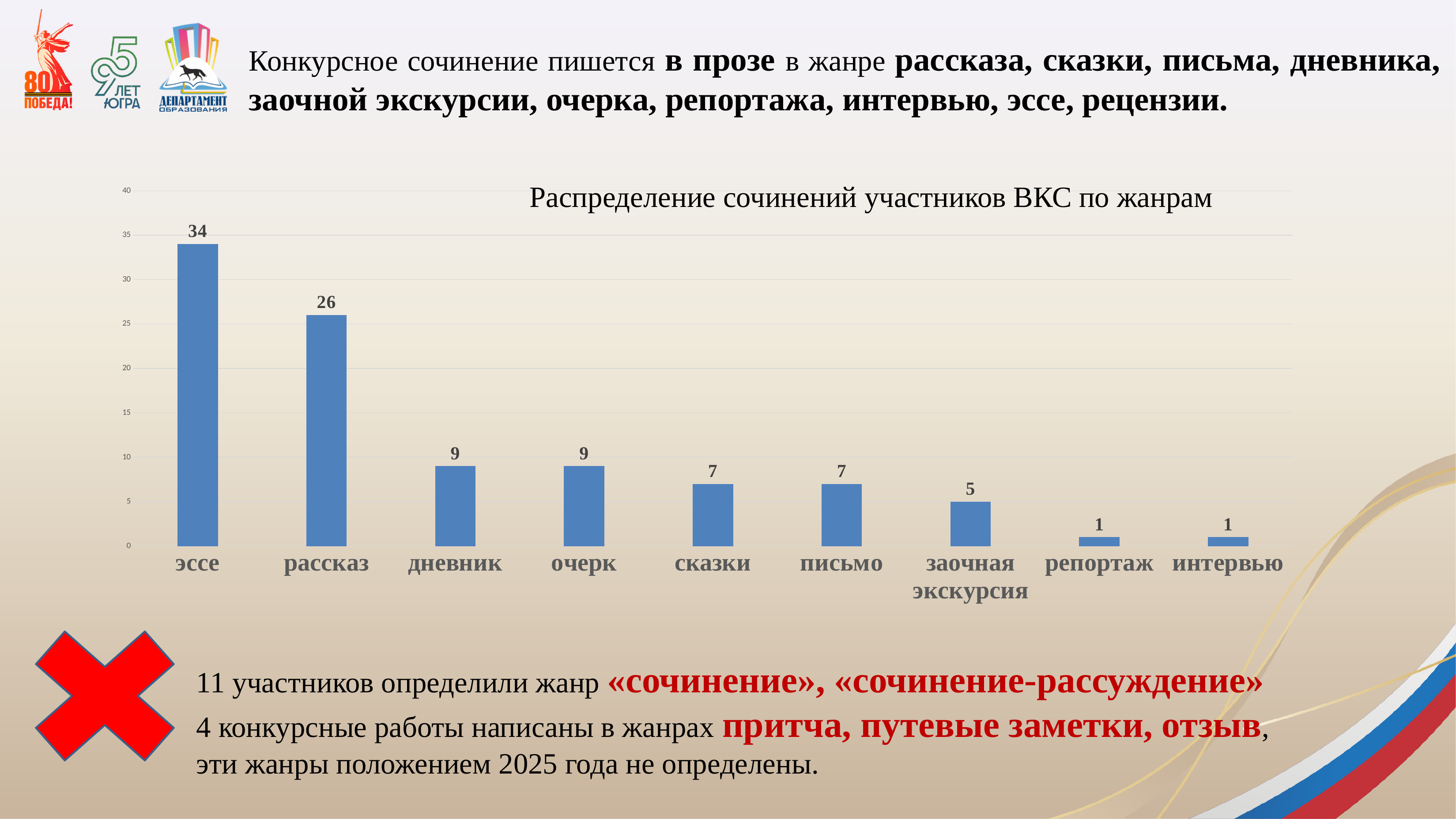
Which is larger, the value for сказки or the value for заочная экскурсия? сказки Do the values rise or fall from left to right along the x axis? fall What is the title of the chart? Распределение сочинений участников ВКС по жанрам What is the value for заочная экскурсия? 5 What is the value for дневник? 9 What is the difference between the values for эссе and рассказ? 8 How many categories are shown on the x axis? 9 What is the value for рассказ? 26 Is the value for рассказ greater or less than 20? greater Which category has the highest value? эссе What is the value for эссе? 34 What kind of chart is shown on the slide? bar chart